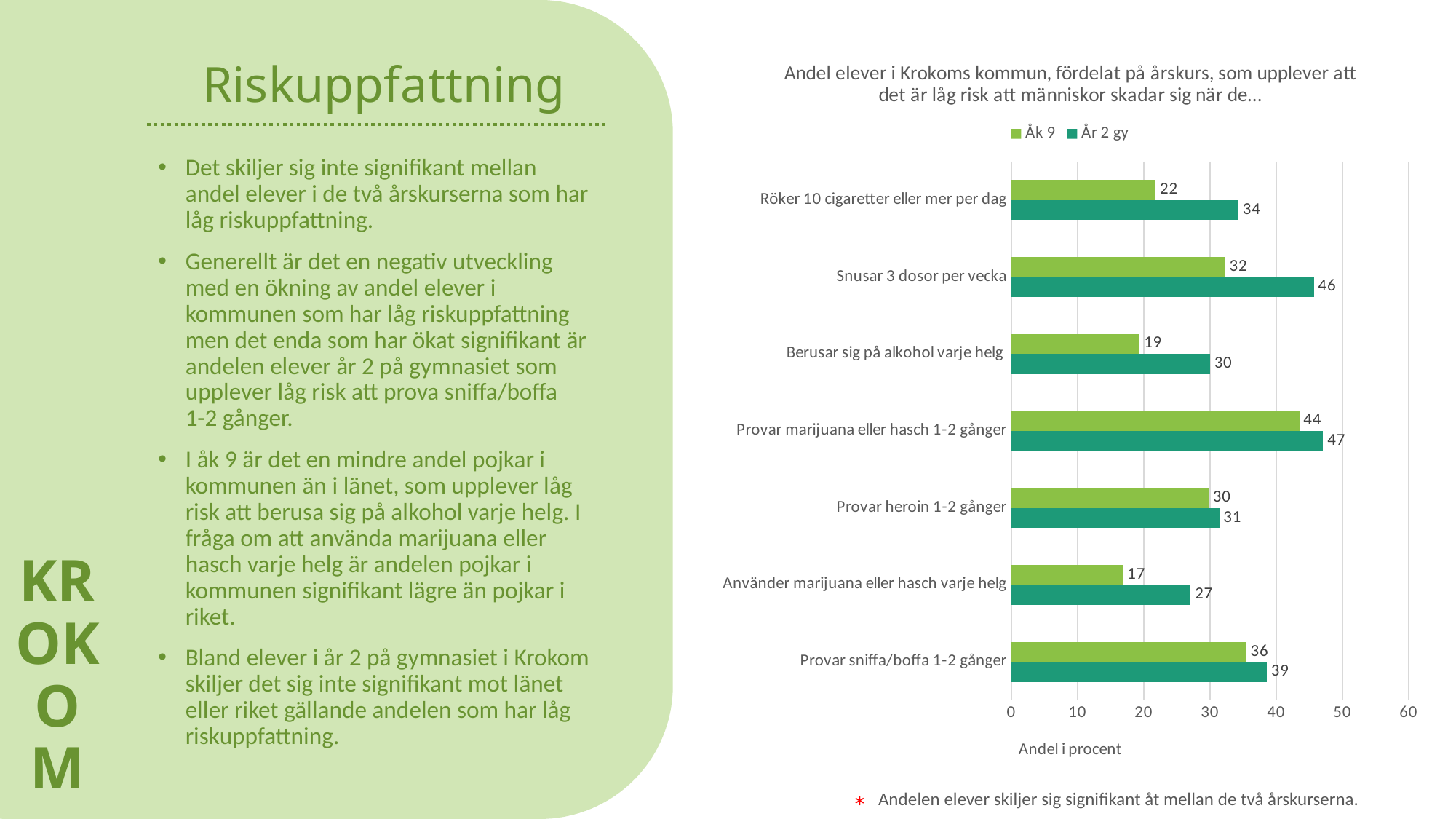
What is the label of the horizontal axis? Andel i procent Which category has the lowest value for År 2 gy? Använder marijuana eller hasch varje helg How many series does the legend list? 2 Which is larger for 'Berusar sig på alkohol varje helg': Åk 9 or År 2 gy? År 2 gy What kind of chart is shown on the slide? Bar chart What is the value for År 2 gy for 'Provar sniffa/boffa 1-2 gånger'? 39 Which category has the lowest value for Åk 9? Använder marijuana eller hasch varje helg What is the difference between År 2 gy and Åk 9 for 'Snusar 3 dosor per vecka'? 14 Which category has the highest value for Åk 9? Provar marijuana eller hasch 1-2 gånger What is the value for År 2 gy for 'Röker 10 cigaretter eller mer per dag'? 34 How many categories are shown on the chart? 7 What is the value for Åk 9 for 'Snusar 3 dosor per vecka'? 32